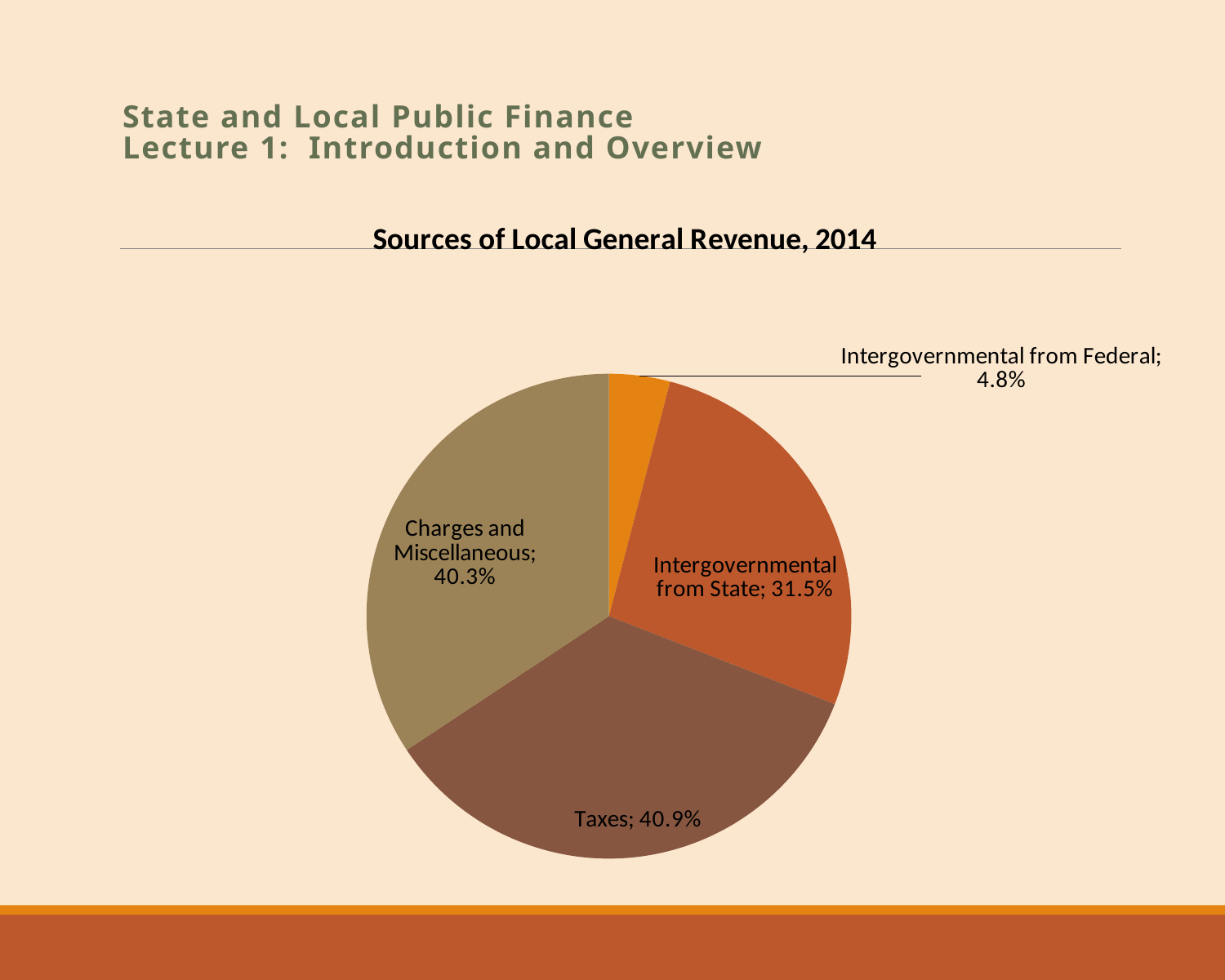
What percentage is shown for Intergovernmental from Federal? 4.8% Which source has the largest share of local general revenue? Taxes What type of chart is shown on the slide? Pie chart What percentage of local general revenue comes from Taxes? 40.9% What percentage is shown for Charges and Miscellaneous? 40.3% Which source has the smallest share of local general revenue? Intergovernmental from Federal What is the difference in percentage points between Taxes and Intergovernmental from State? 9.4 What percentage is shown for Intergovernmental from State? 31.5% What is the difference in percentage points between Intergovernmental from State and Intergovernmental from Federal? 26.7 Which is larger, Intergovernmental from State or Intergovernmental from Federal? Intergovernmental from State How many slices does the pie chart have? 4 What is the title of the chart? Sources of Local General Revenue, 2014